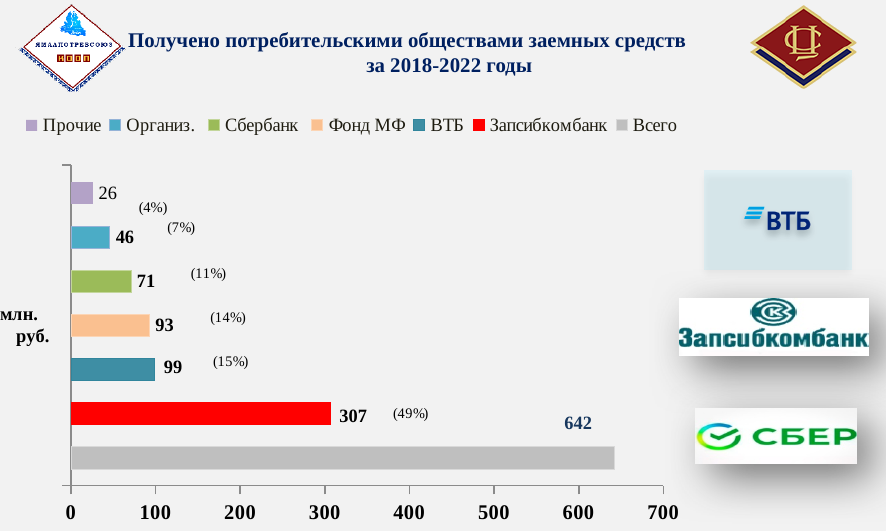
What is the value of the Всего bar? 642 What value is shown for Запсибкомбанк? 307 What value is shown for Сбербанк? 71 How many entries does the legend list? 7 What type of chart is shown on the slide? Bar chart What value is shown for Фонд МФ? 93 What value is shown for ВТБ? 99 Excluding the Всего bar, which source has the highest value? Запсибкомбанк What is the difference between the values for ВТБ and Фонд МФ? 6 What percentage share is printed next to the Запсибкомбанк bar? (49%) Excluding the Всего bar, which source has the lowest value? Прочие Which is larger, the value for Организ. or the value for Сбербанк? Сбербанк